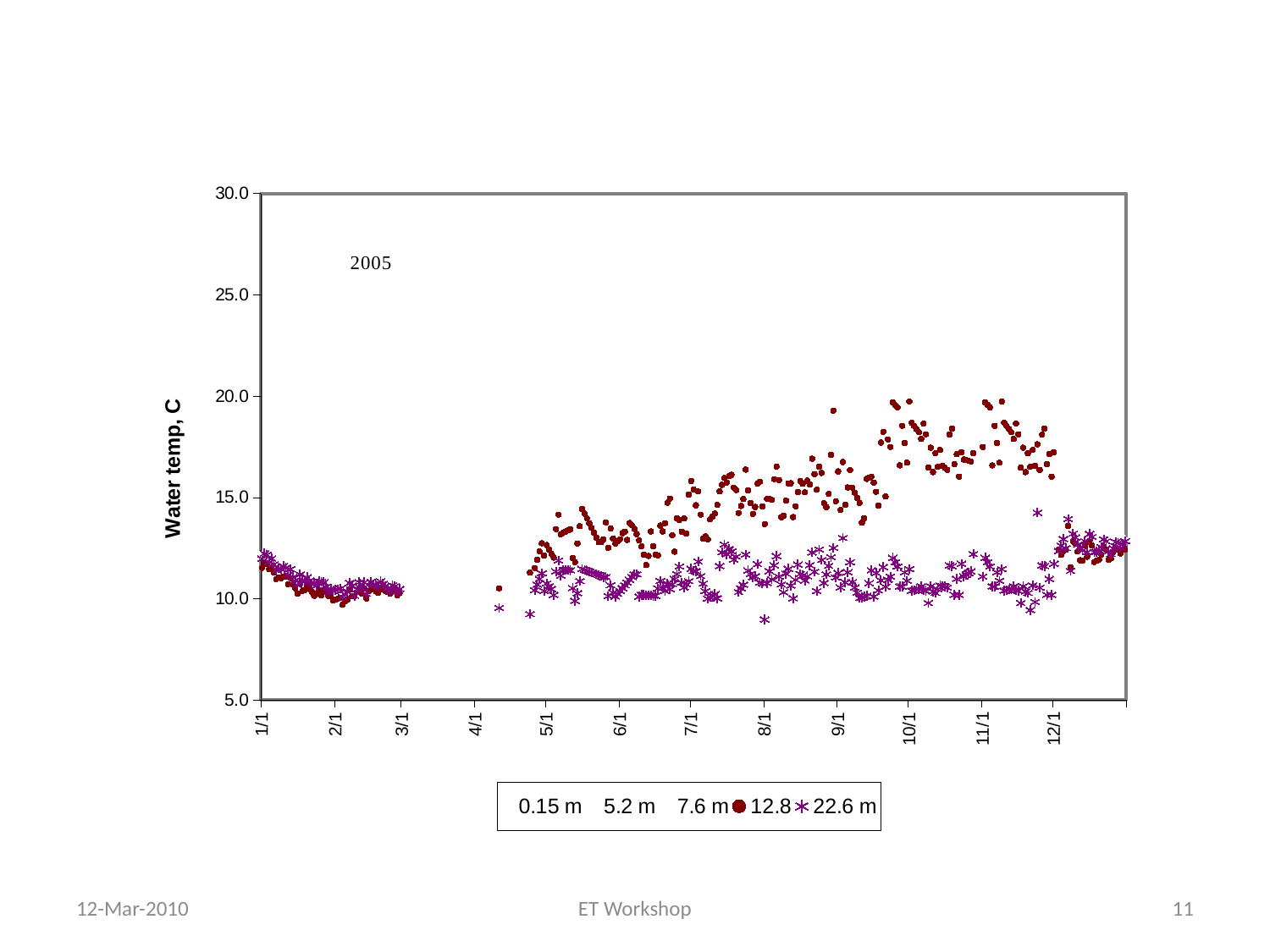
Is the value of the 12.8 series around 2/1 greater or less than 15.0? less Is the value of the 22.6 m series around 8/1 greater or less than 15.0? less Is the value of the 22.6 m series around 10/1 greater or less than 15.0? less Around 10/1, which series has the higher water temperature, 12.8 or 22.6 m? 12.8 Does the 12.8 series generally rise or fall between 5/1 and 10/1? rise What kind of chart is shown on the slide? scatter chart How many series does the legend list? 5 What year is annotated inside the plot area? 2005 What is the highest value shown on the vertical axis? 30.0 How many month tick labels are shown on the x axis? 12 What is the label of the vertical axis? Water temp, C